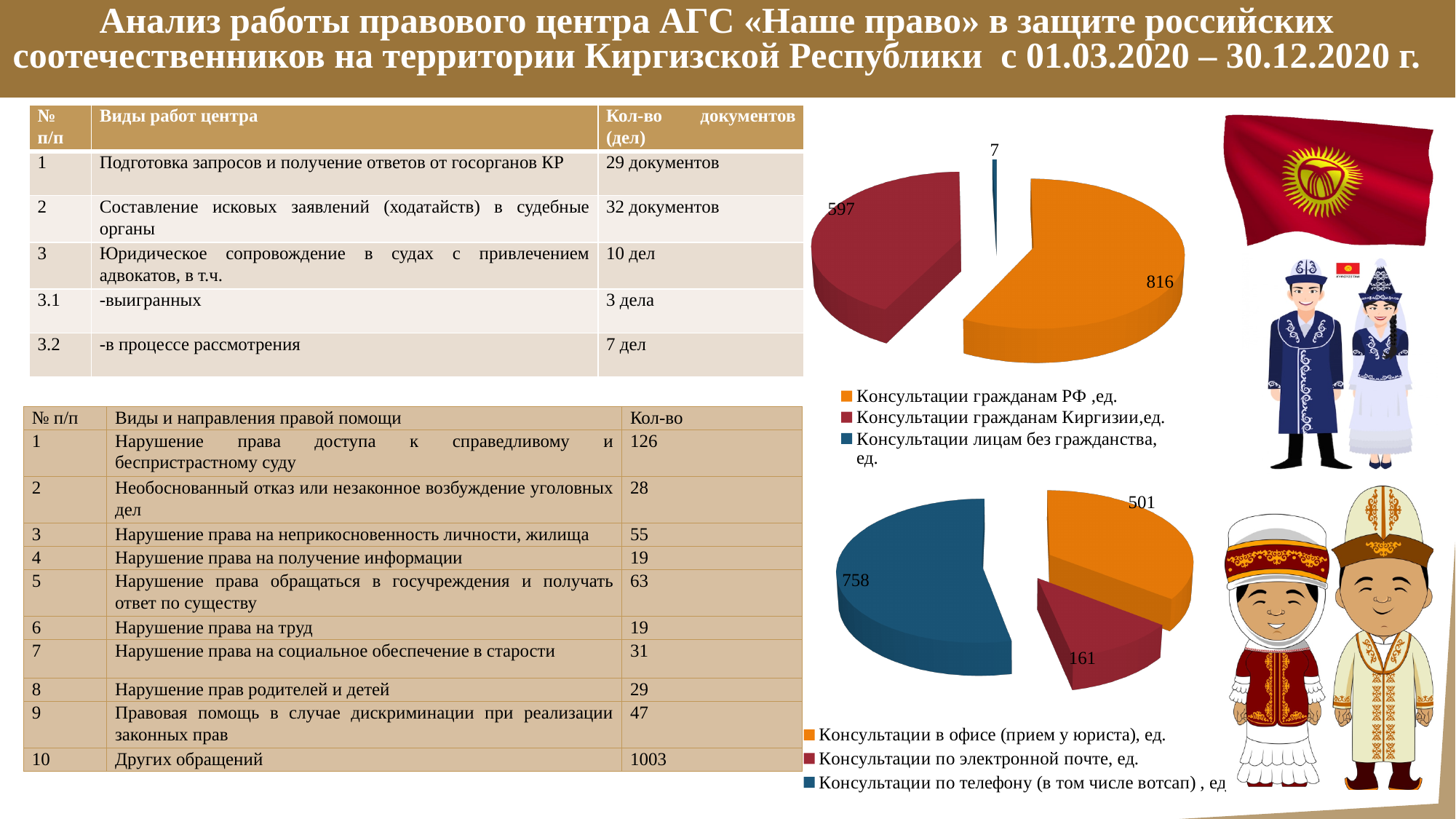
In the bottom pie chart, which is larger: consultations in the office or consultations by e-mail? Консультации в офисе (прием у юриста), ед. In the top pie chart, which category has the smallest value? Консультации лицам без гражданства, ед. In the top pie chart, what is the value for consultations to citizens of Kyrgyzstan (Консультации гражданам Киргизии)? 597 What type of chart is the bottom chart on the slide? Pie chart In the bottom pie chart, what is the value for consultations in the office (Консультации в офисе)? 501 In the bottom pie chart, which category has the largest value? Консультации по телефону (в том числе вотсап), ед. In the top pie chart, what is the value for consultations to citizens of the Russian Federation (Консультации гражданам РФ)? 816 In the bottom pie chart, what is the difference between consultations by phone and consultations by e-mail? 597 In the top pie chart, what is the total of all three slices? 1420 In the top pie chart, what is the value for consultations to stateless persons (Консультации лицам без гражданства)? 7 In the top pie chart, what is the difference between consultations to RF citizens and consultations to Kyrgyz citizens? 219 In the bottom pie chart, what is the value for consultations by e-mail (Консультации по электронной почте)? 161